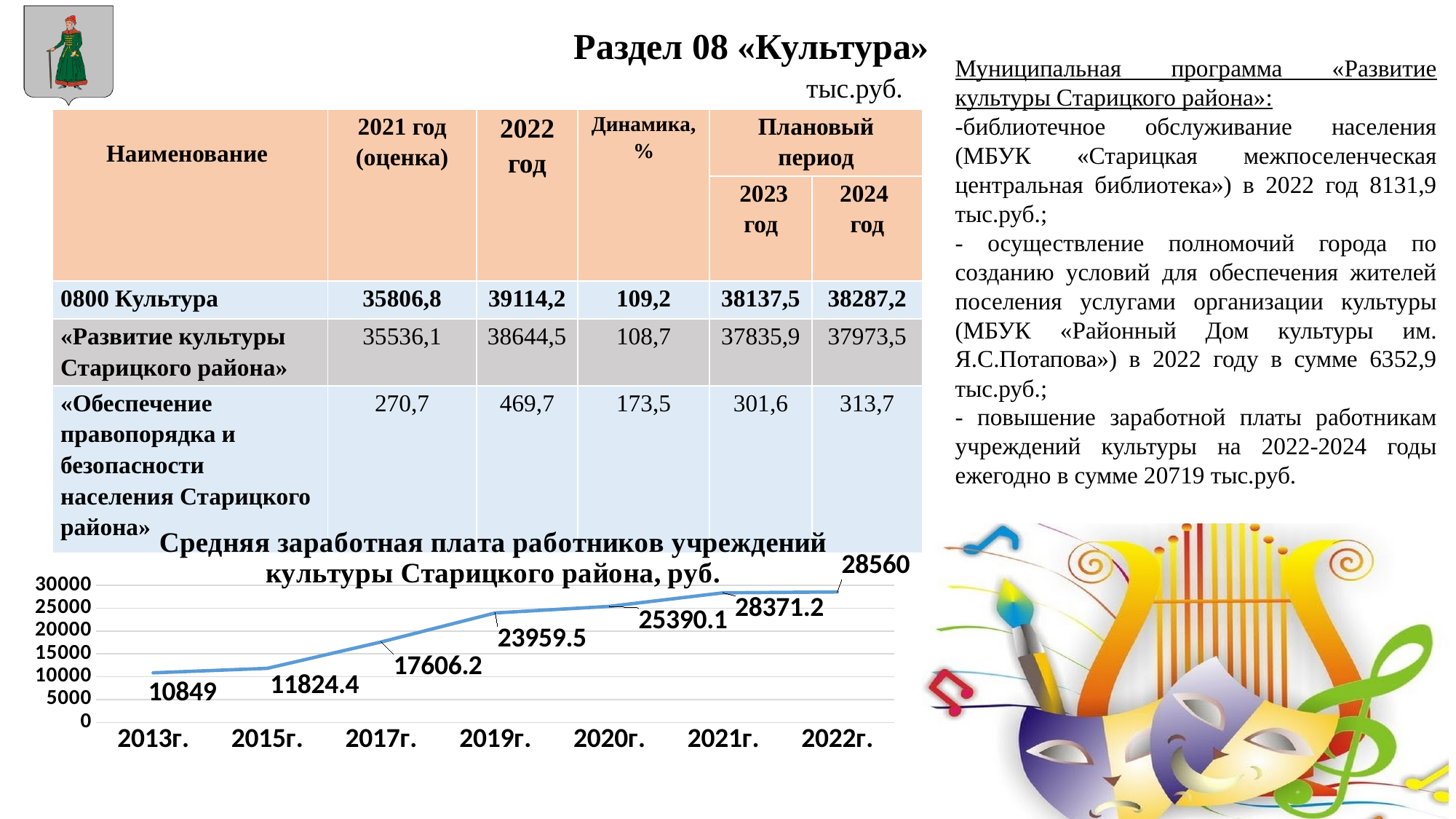
Do the values rise or fall from 2013г. to 2022г.? rise What is the difference between the values for 2015г. and 2013г.? 975.4 Which year has the highest value in the chart? 2022г. What is the average salary value shown for 2013г.? 10849 How many years (data points) are plotted in the chart? 7 Which year has the lowest value in the chart? 2013г. What is the difference between the values for 2022г. and 2021г.? 188.8 What is the value shown for 2019г. in the chart? 23959.5 What type of chart is shown on the slide? line chart Which is larger, the value for 2020г. or the value for 2019г.? 2020г. What is the value shown for 2017г. in the chart? 17606.2 What is the value shown for 2022г. in the chart? 28560